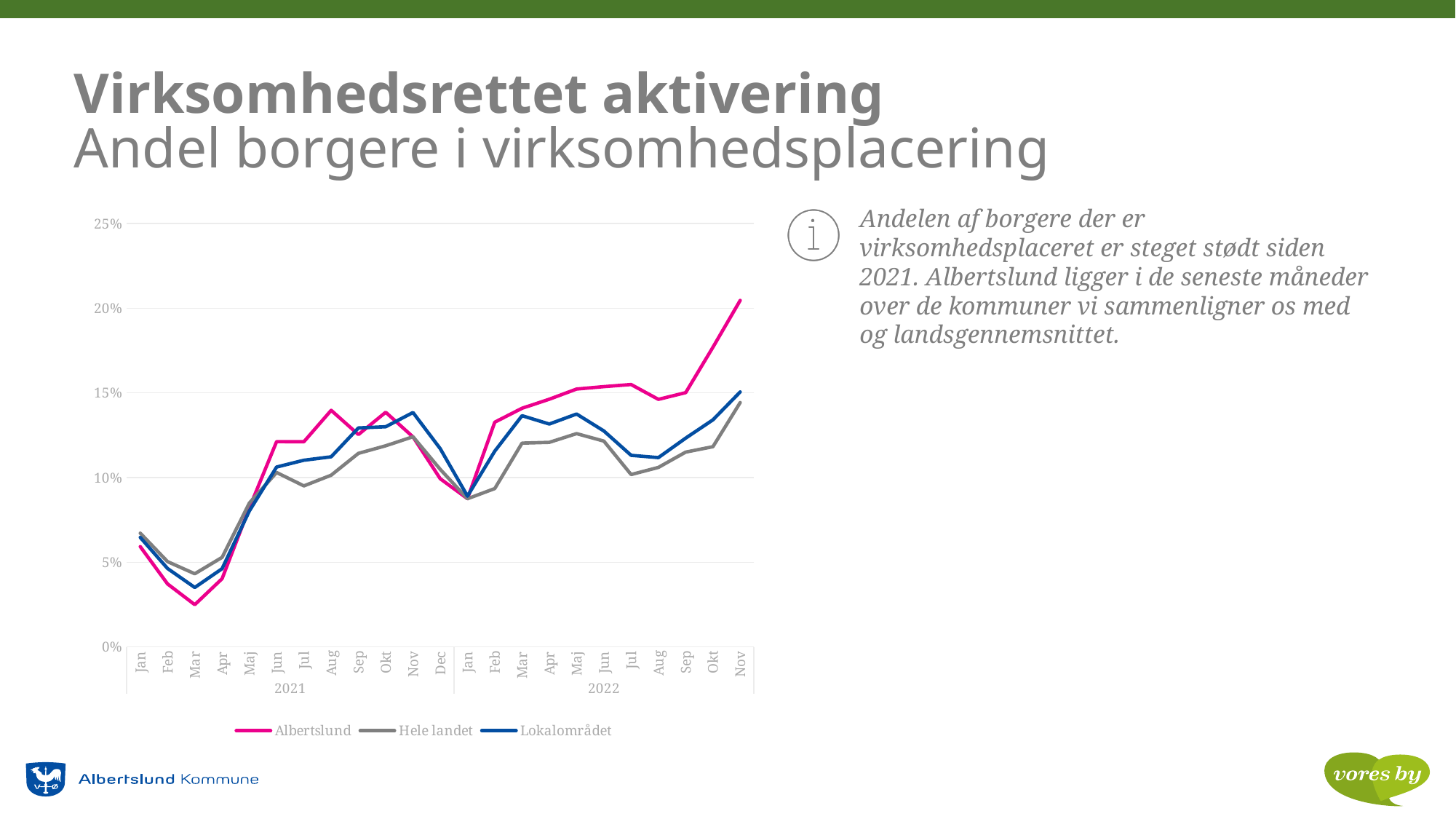
Does the Albertslund series rise or fall from Jan 2022 to Nov 2022? rise Which series has the highest value in Nov 2022? Albertslund Is the value for Albertslund in Nov 2022 greater or less than 20%? greater Which colour is used for the Lokalområdet series? blue How many monthly data points are plotted along the x axis for each series? 23 Which series has the lowest value in Mar 2021? Albertslund Which series are listed in the legend? Albertslund, Hele landet, Lokalområdet What kind of chart is shown on the slide? line chart How many series does the legend list? 3 In Jul 2022, which is larger: the value for Albertslund or the value for Hele landet? Albertslund Is the value for Albertslund in Mar 2021 greater or less than 5%? less Is the value for Hele landet in Nov 2022 greater or less than 15%? less